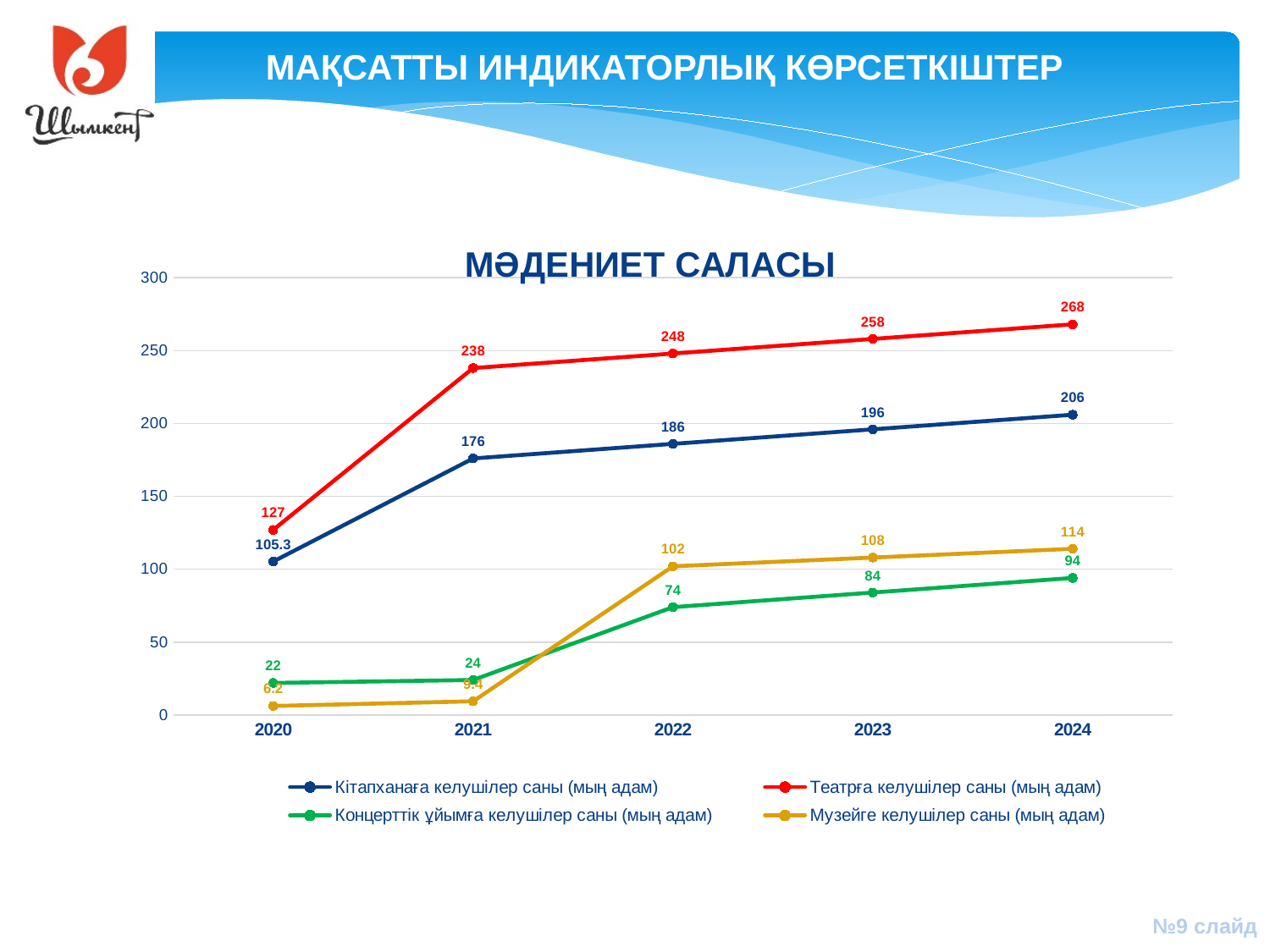
Which is larger in 2022: Музейге келушілер саны or Концерттік ұйымға келушілер саны? Музейге келушілер саны (мың адам) Does Театрға келушілер саны (мың адам) rise or fall from 2020 to 2024? rise What is the value for Кітапханаға келушілер саны (мың адам) in 2020? 105.3 How many years are shown on the x axis? 5 What is the value for Музейге келушілер саны (мың адам) in 2021? 9.4 What type of chart is shown on the slide? line chart How many series does the legend list? 4 What is the title of the chart? МӘДЕНИЕТ САЛАСЫ What is the difference between Театрға келушілер саны and Кітапханаға келушілер саны in 2023? 62 In which year is Музейге келушілер саны (мың адам) lowest? 2020 What is the value for Театрға келушілер саны (мың адам) in 2024? 268 In which year is Концерттік ұйымға келушілер саны (мың адам) highest? 2024